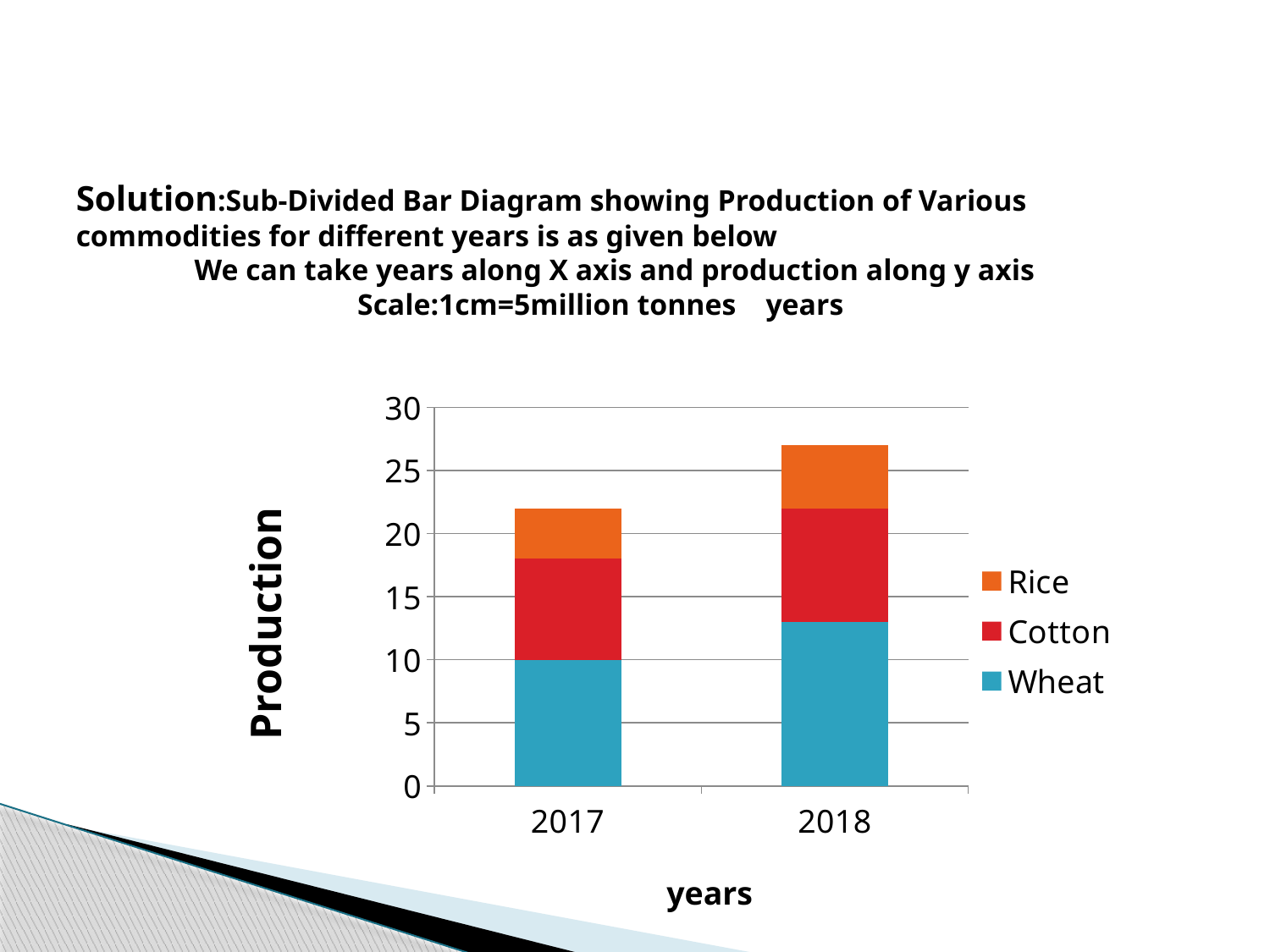
Which series is shown in orange in the chart's legend? Rice What is the title of the vertical axis of the chart? Production Does total production rise or fall from 2017 to 2018? rise Is the total production for 2018 greater or less than 25? greater Which year has the taller total bar, 2017 or 2018? 2018 Is the Wheat value for 2018 greater or less than 15? less How many years are shown on the x axis of the chart? 2 What is the Wheat production value for 2017? 10 What kind of chart is shown on the slide? Stacked bar chart Is the total production for 2017 greater or less than 20? greater How many series does the chart's legend list? 3 Which year has the larger Wheat segment? 2018